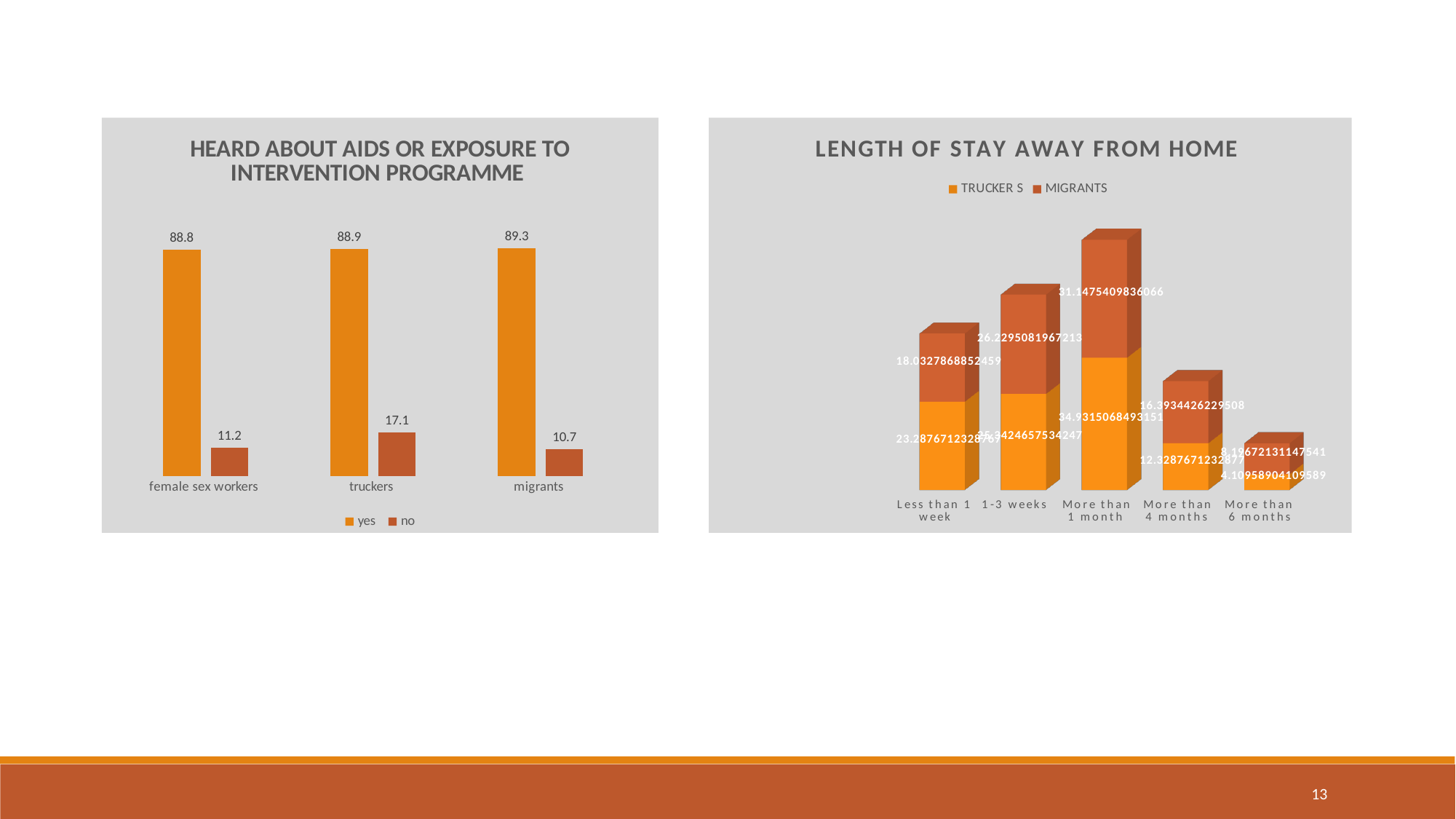
In the chart titled 'LENGTH OF STAY AWAY FROM HOME', which category has the tallest stacked bar? More than 1 month In the chart titled 'LENGTH OF STAY AWAY FROM HOME', what is the MIGRANTS value for 'More than 4 months'? 16.3934426229508 In the chart titled 'LENGTH OF STAY AWAY FROM HOME', what is the MIGRANTS value for 'More than 1 month'? 31.1475409836066 In the chart titled 'LENGTH OF STAY AWAY FROM HOME', what is the TRUCKERS value for 'More than 6 months'? 4.10958904109589 In the chart titled 'HEARD ABOUT AIDS OR EXPOSURE TO INTERVENTION PROGRAMME', what is the 'yes' value for truckers? 88.9 In the chart titled 'LENGTH OF STAY AWAY FROM HOME', how many series does the legend list? 2 In the chart titled 'HEARD ABOUT AIDS OR EXPOSURE TO INTERVENTION PROGRAMME', which group has the highest 'no' value? truckers In the chart titled 'HEARD ABOUT AIDS OR EXPOSURE TO INTERVENTION PROGRAMME', what is the difference between the 'yes' and 'no' values for female sex workers? 77.6 In the chart titled 'HEARD ABOUT AIDS OR EXPOSURE TO INTERVENTION PROGRAMME', how many groups are shown on the x axis? 3 In the chart titled 'HEARD ABOUT AIDS OR EXPOSURE TO INTERVENTION PROGRAMME', what is the 'no' value for migrants? 10.7 In the chart titled 'HEARD ABOUT AIDS OR EXPOSURE TO INTERVENTION PROGRAMME', which is larger: the 'no' value for truckers or the 'no' value for female sex workers? truckers What kind of chart is the chart titled 'LENGTH OF STAY AWAY FROM HOME'? stacked bar chart